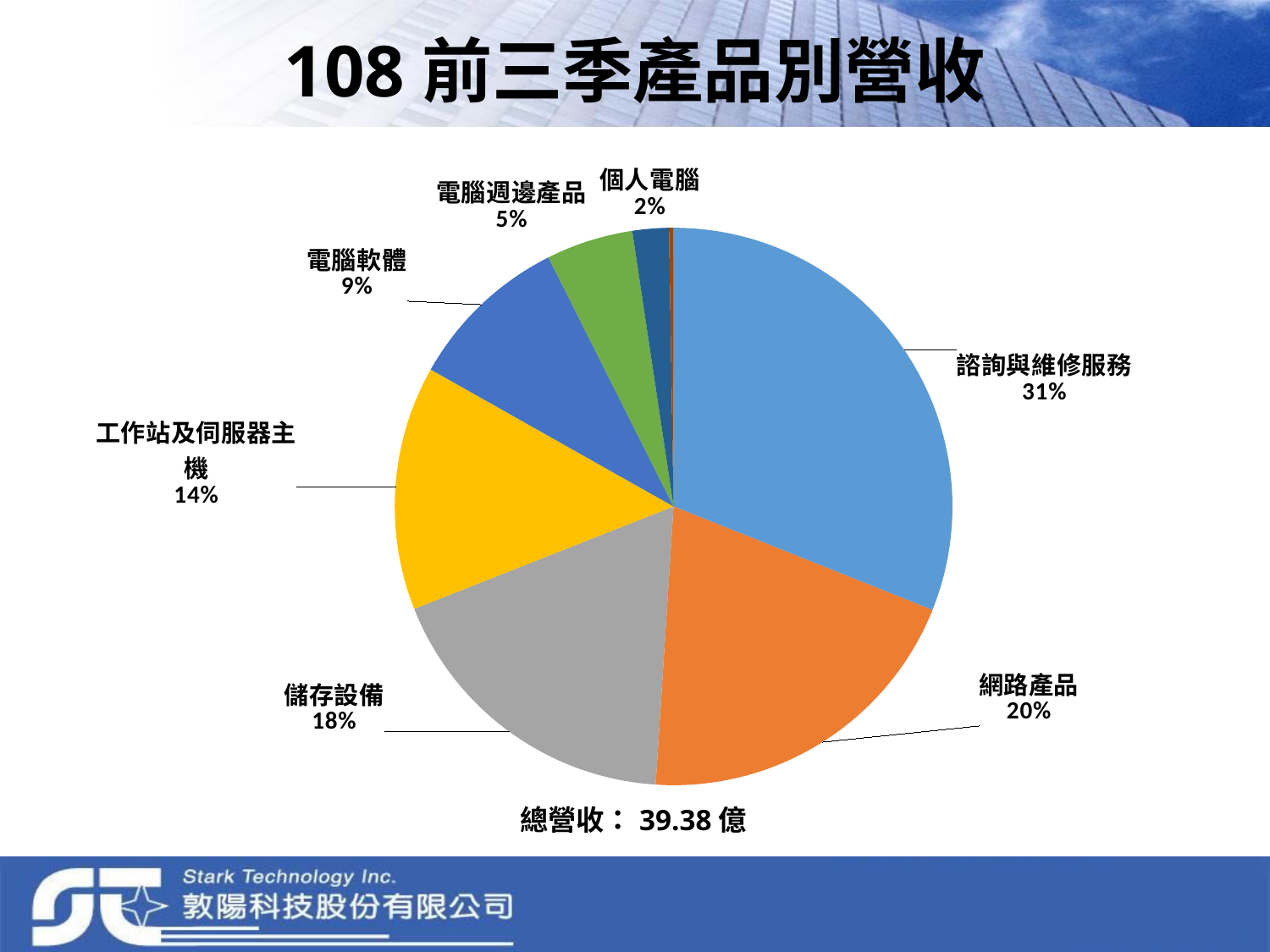
What share of revenue does 電腦軟體 account for? 9% What share of revenue does 工作站及伺服器主機 account for? 14% What share of revenue does 諮詢與維修服務 account for? 31% What total revenue is stated below the chart? 39.38 億 Which product category has the largest share of revenue? 諮詢與維修服務 Which has a larger share, 電腦週邊產品 or 電腦軟體? 電腦軟體 What kind of chart is shown on the slide? Pie chart What is the difference in share between 網路產品 and 儲存設備? 2%